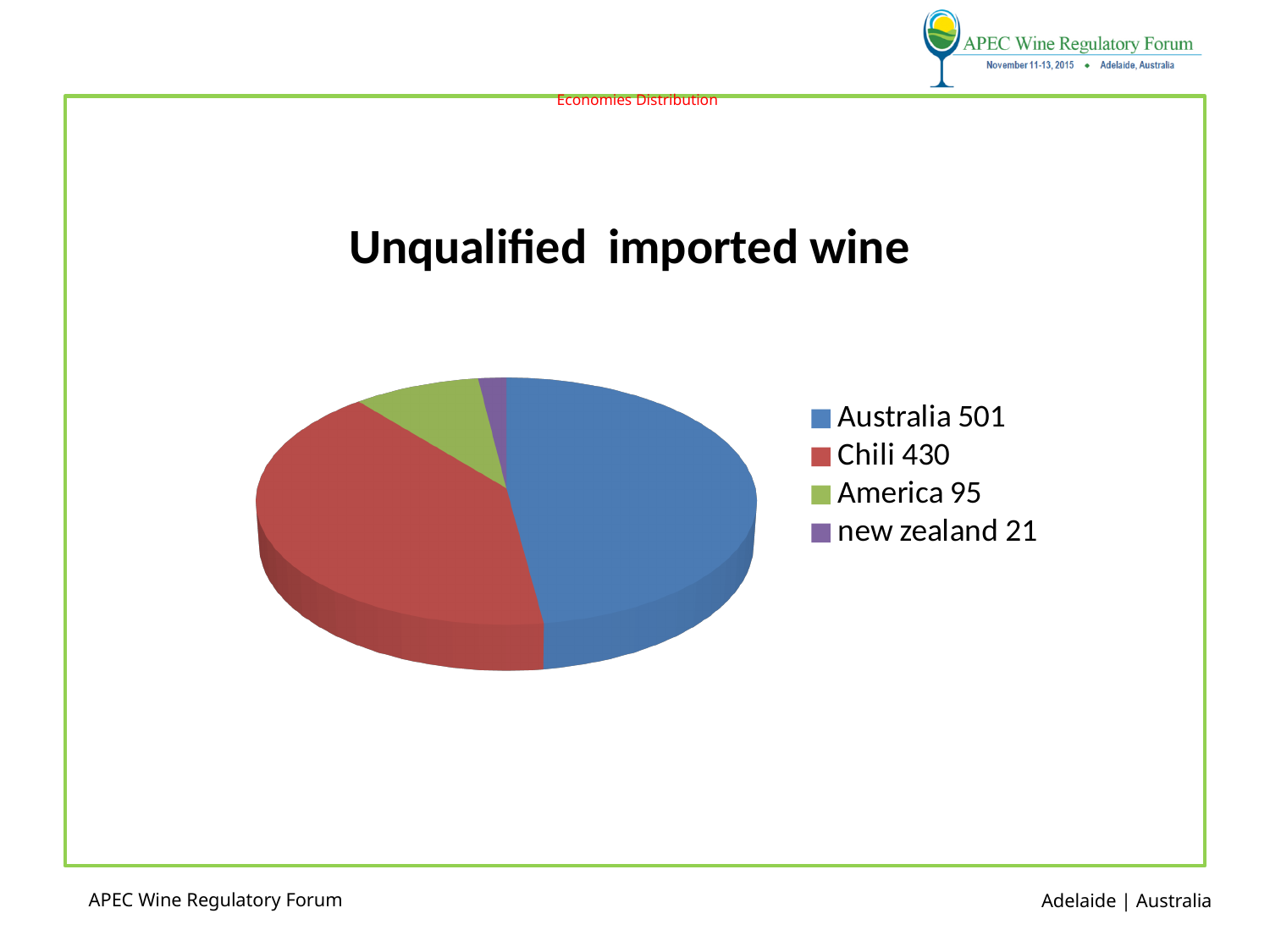
What is the difference between the values for Chili and America? 335 Which category has the smallest slice in the pie chart? new zealand What is the title of the chart? Unqualified imported wine What is the value for America in the pie chart? 95 Which category has the largest slice in the pie chart? Australia What is the difference between the values for Australia and Chili? 71 What is the value for Chili in the pie chart? 430 Which is larger, the value for Chili or the value for America? Chili What is the value for Australia in the pie chart? 501 How many categories are shown in the pie chart? 4 What kind of chart is shown on the slide? Pie chart What is the value for new zealand in the pie chart? 21